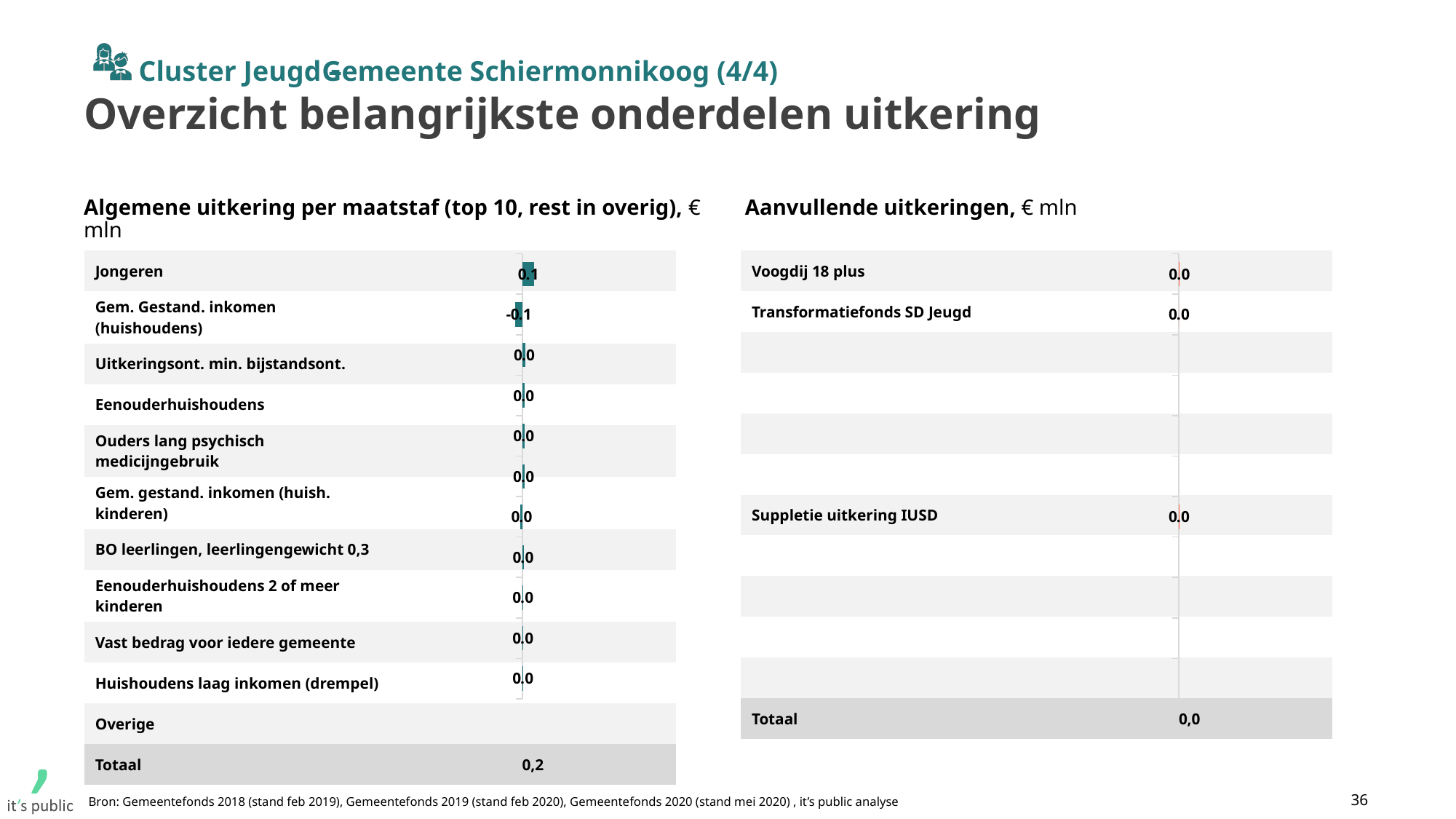
In the chart 'Algemene uitkering per maatstaf', what is the value for Vast bedrag voor iedere gemeente? 0,0 In the chart 'Algemene uitkering per maatstaf', which category has the highest value? Jongeren In the chart 'Algemene uitkering per maatstaf', what is the value for Jongeren? 0,1 In the chart 'Aanvullende uitkeringen', how many named categories are shown (excluding Totaal)? 3 In the chart 'Algemene uitkering per maatstaf', what is the difference between the values for Jongeren and Gem. Gestand. inkomen (huishoudens)? 0,2 In the chart 'Algemene uitkering per maatstaf', which category has the lowest value? Gem. Gestand. inkomen (huishoudens) In the chart 'Aanvullende uitkeringen', what is the Totaal value? 0,0 What kind of chart is used for 'Aanvullende uitkeringen'? Bar chart In the chart 'Algemene uitkering per maatstaf', which is larger: the value for Jongeren or the value for Gem. Gestand. inkomen (huishoudens)? Jongeren In the chart 'Algemene uitkering per maatstaf', what is the value for Gem. Gestand. inkomen (huishoudens)? -0,1 In the chart 'Algemene uitkering per maatstaf', what is the Totaal value? 0,2 In the chart 'Aanvullende uitkeringen', what is the value for Voogdij 18 plus? 0,0